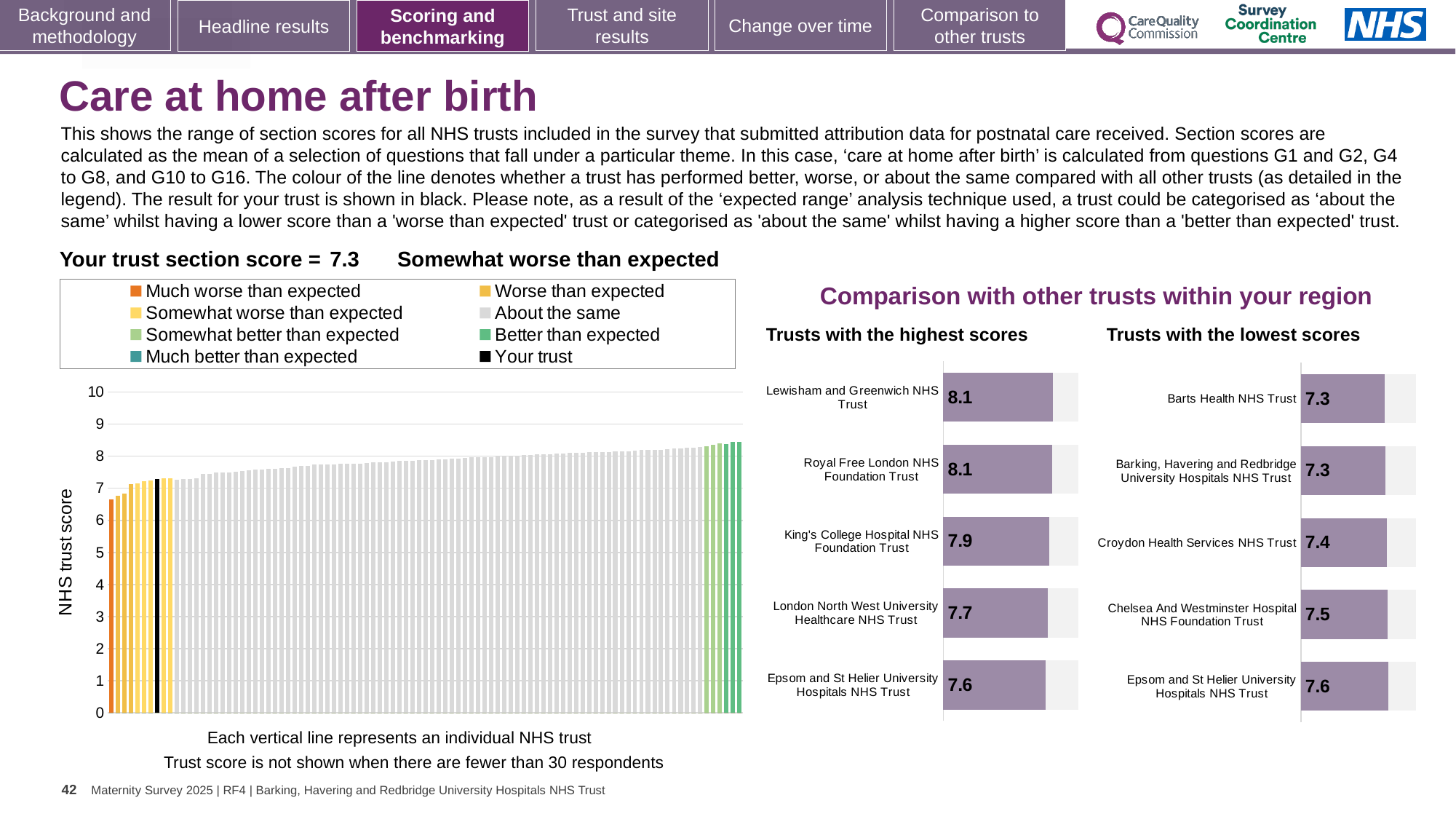
In the 'Trusts with the lowest scores' chart, what is the score for Croydon Health Services NHS Trust? 7.4 In the 'Trusts with the highest scores' chart, what is the difference between the scores of Lewisham and Greenwich NHS Trust and Epsom and St Helier University Hospitals NHS Trust? 0.5 In the 'Trusts with the lowest scores' chart, what is the score for Barking, Havering and Redbridge University Hospitals NHS Trust? 7.3 In the 'Trusts with the highest scores' chart, what is the score for King's College Hospital NHS Foundation Trust? 7.9 In the 'Trusts with the lowest scores' chart, what is the difference between the scores of Chelsea And Westminster Hospital NHS Foundation Trust and Barts Health NHS Trust? 0.2 What kind of chart is the large 'NHS trust score' chart on the left of the slide? Bar chart In the 'Trusts with the highest scores' chart, which trust has the lowest score? Epsom and St Helier University Hospitals NHS Trust In the 'Trusts with the lowest scores' chart, which trust has the highest score? Epsom and St Helier University Hospitals NHS Trust In the legend of the large 'NHS trust score' chart, what colour represents 'Your trust'? Black How many trusts are shown in the 'Trusts with the highest scores' chart? 5 In the large 'NHS trust score' chart on the left, do the bar values rise or fall from left to right? Rise Which has the higher score: London North West University Healthcare NHS Trust in the highest-scores chart or Chelsea And Westminster Hospital NHS Foundation Trust in the lowest-scores chart? London North West University Healthcare NHS Trust